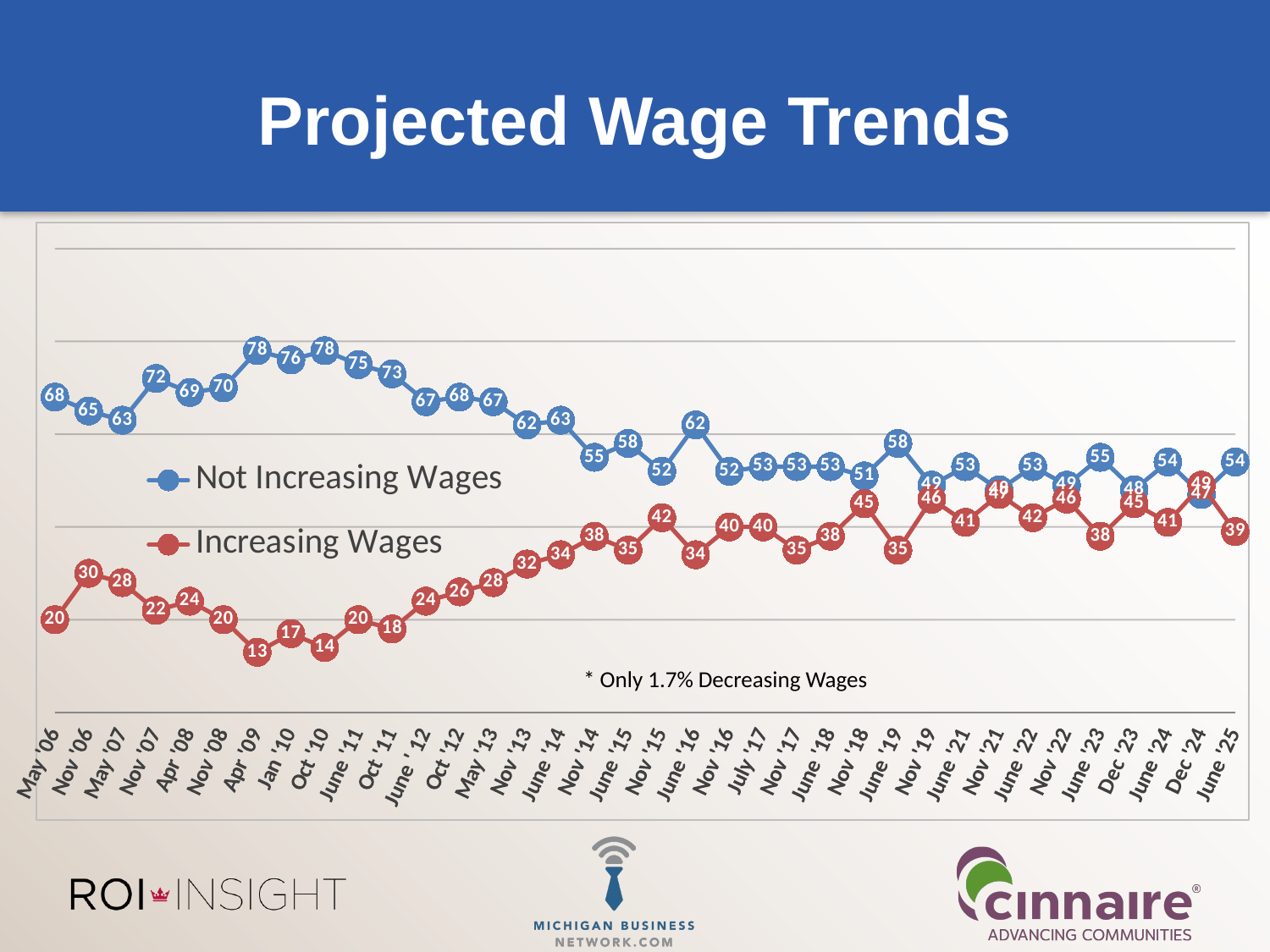
What is the value for Increasing Wages at Nov '06? 30 What is the value for Increasing Wages at May '06? 20 What is the difference between Not Increasing Wages and Increasing Wages at May '06? 48 What type of chart is shown on the slide? line chart How many series does the legend list? 2 Does the Not Increasing Wages series generally rise or fall from Oct '10 to Nov '14? fall What is the title of the slide? Projected Wage Trends What is the lowest value plotted for the Increasing Wages series? 13 At Nov '06, which series has the larger value, Not Increasing Wages or Increasing Wages? Not Increasing Wages What is the highest value plotted for the Not Increasing Wages series? 78 What is the value for Not Increasing Wages at May '06? 68 What does the footnote on the chart say about decreasing wages? Only 1.7% Decreasing Wages